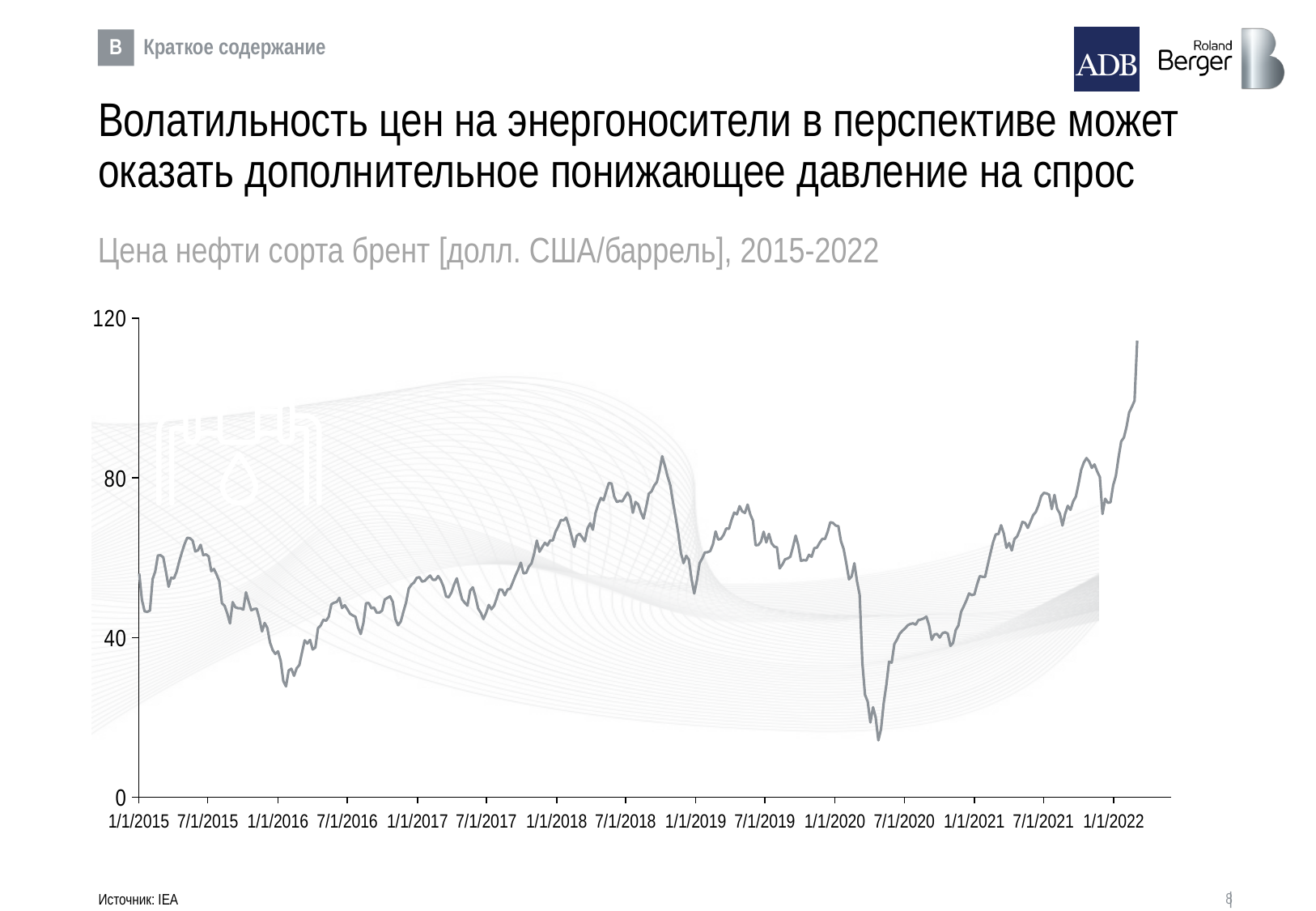
Is the value at the end of the line in early 2022 greater or less than 80? greater What kind of chart is shown on the slide? line chart What is the title of the chart? Цена нефти сорта брент [долл. США/баррель], 2015-2022 How many date labels are shown on the x axis? 15 Is the lowest value of the line, reached in 2020, greater or less than 40? less In which year does the line reach its lowest point? 2020 Does the line rise or fall between 7/1/2020 and 1/1/2022? rise Does the line rise or fall between 1/1/2020 and 7/1/2020? fall Is the value at 1/1/2019 greater or less than 80? less What source is cited for the chart? IEA In which year does the line reach its highest point? 2022